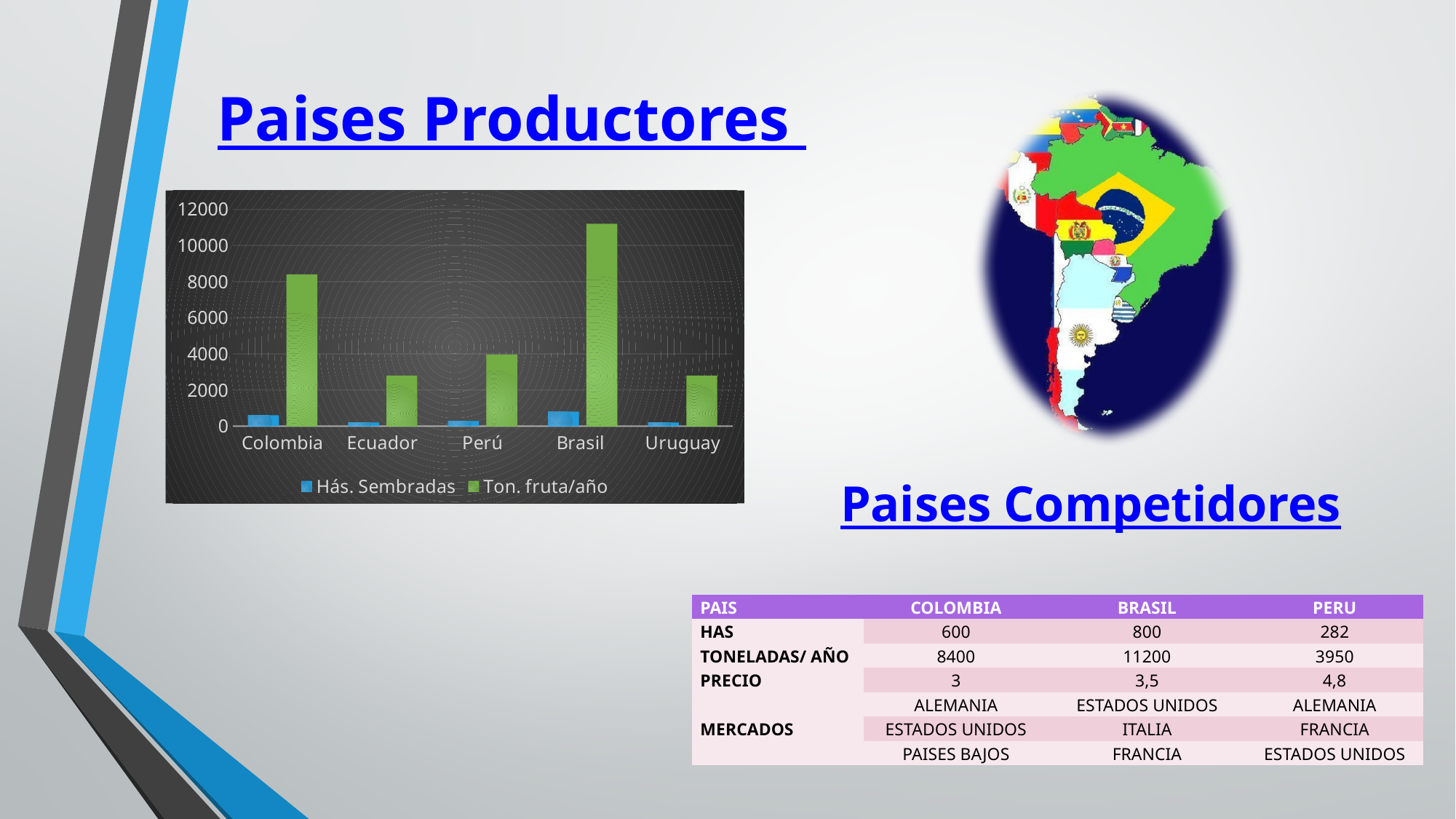
Is the Hás. Sembradas value for Colombia greater or less than 2000? less Is the Ton. fruta/año value for Brasil greater or less than 10000? greater What are the two series named in the chart's legend? Hás. Sembradas and Ton. fruta/año Which is larger, the Ton. fruta/año value for Colombia or for Perú? Colombia Is the Ton. fruta/año value for Perú greater or less than 6000? less Which country has the highest value for Ton. fruta/año? Brasil What kind of chart is shown under the title "Paises Productores"? bar chart Which country has the highest value for Hás. Sembradas? Brasil How many countries are shown on the x axis of the chart? 5 How many series does the chart's legend list? 2